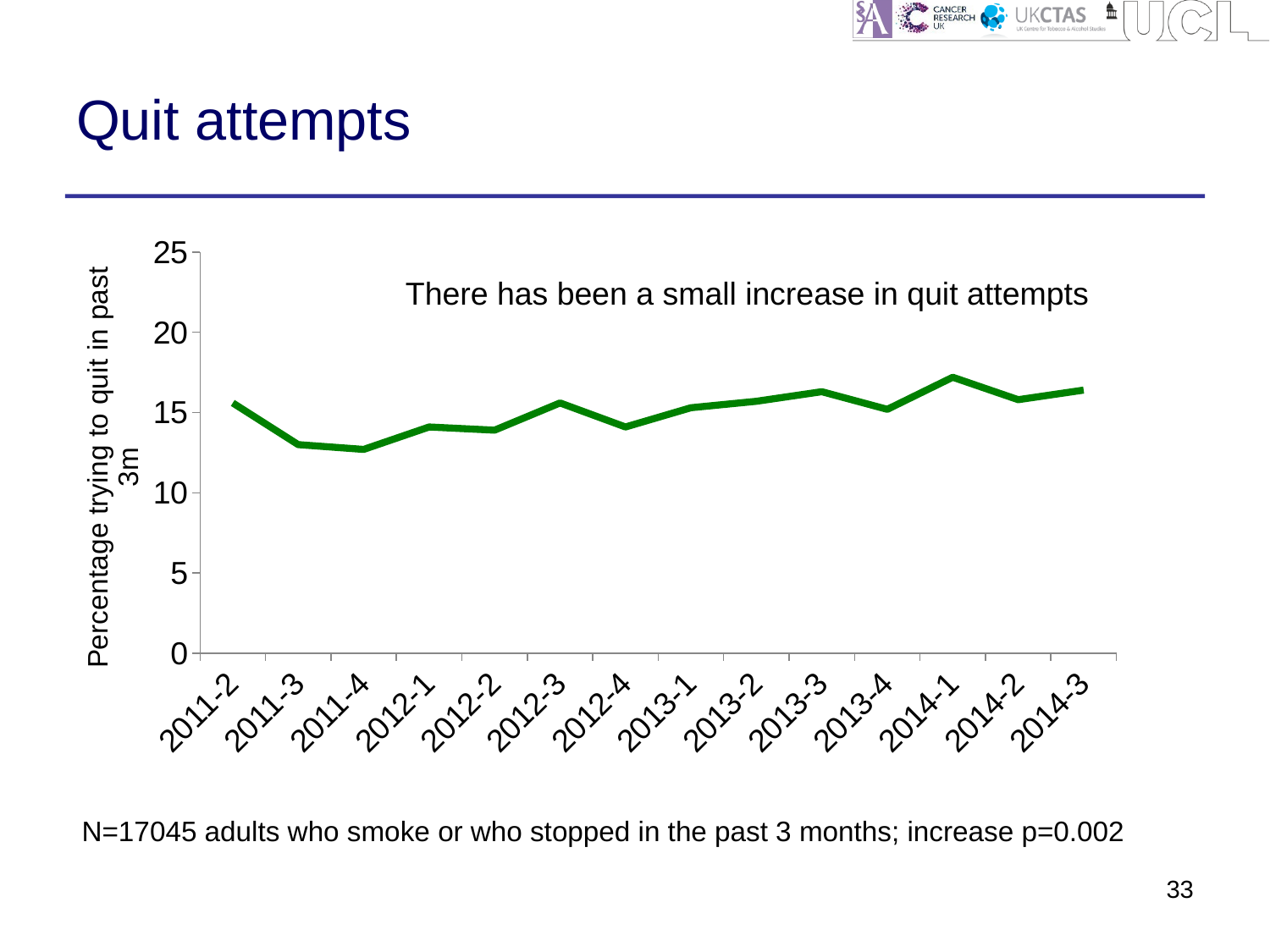
Is the value for 2013-3 greater or less than 20? less Is the value for 2011-4 greater or less than 15? less Overall, do the values rise or fall from 2011-2 to 2014-3? rise What colour is the plotted line? green How many time points are plotted along the x axis? 14 What kind of chart is shown on the slide? line chart Which quarter has the highest percentage trying to quit in the past 3 months? 2014-1 Is the value for 2011-3 greater or less than 15? less Which is larger, the value for 2014-1 or the value for 2011-4? 2014-1 What is the label on the y axis of the chart? Percentage trying to quit in past 3m Which is larger, the value for 2011-3 or the value for 2013-3? 2013-3